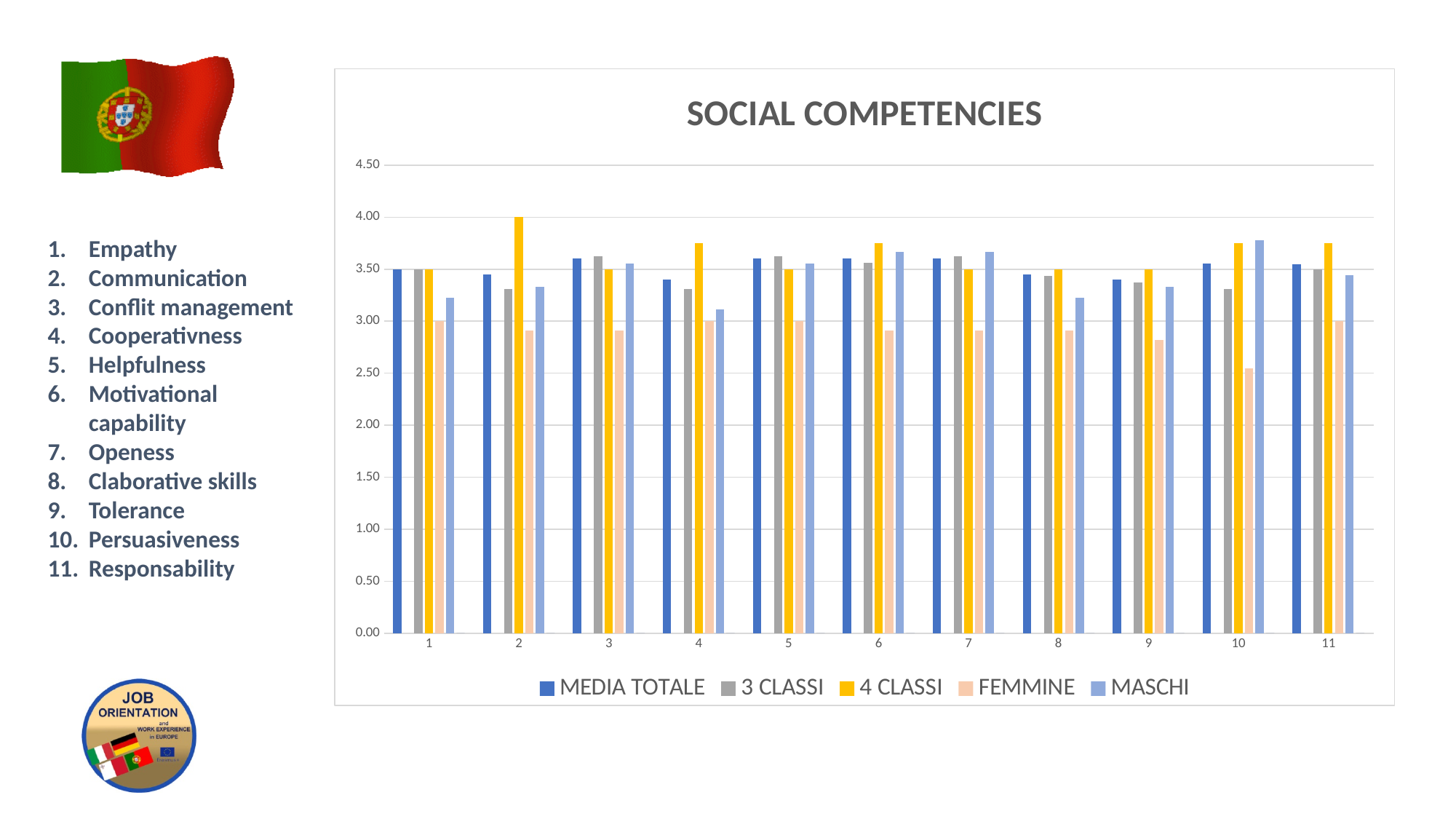
Is the FEMMINE value for category 10 greater or less than 3.00? less For category 2, which is larger: the 4 CLASSI value or the 3 CLASSI value? 4 CLASSI How many series does the chart legend list? 5 For which category is the FEMMINE bar the lowest? 10 What kind of chart is shown on the slide? Bar chart What is the title of the chart? SOCIAL COMPETENCIES For category 10, which is larger: the MASCHI value or the FEMMINE value? MASCHI How many categories are plotted along the x axis of the chart? 11 Is the 4 CLASSI value for category 2 greater or less than 3.50? greater Is the MASCHI value for category 10 greater or less than 3.50? greater For which category is the 4 CLASSI bar the highest? 2